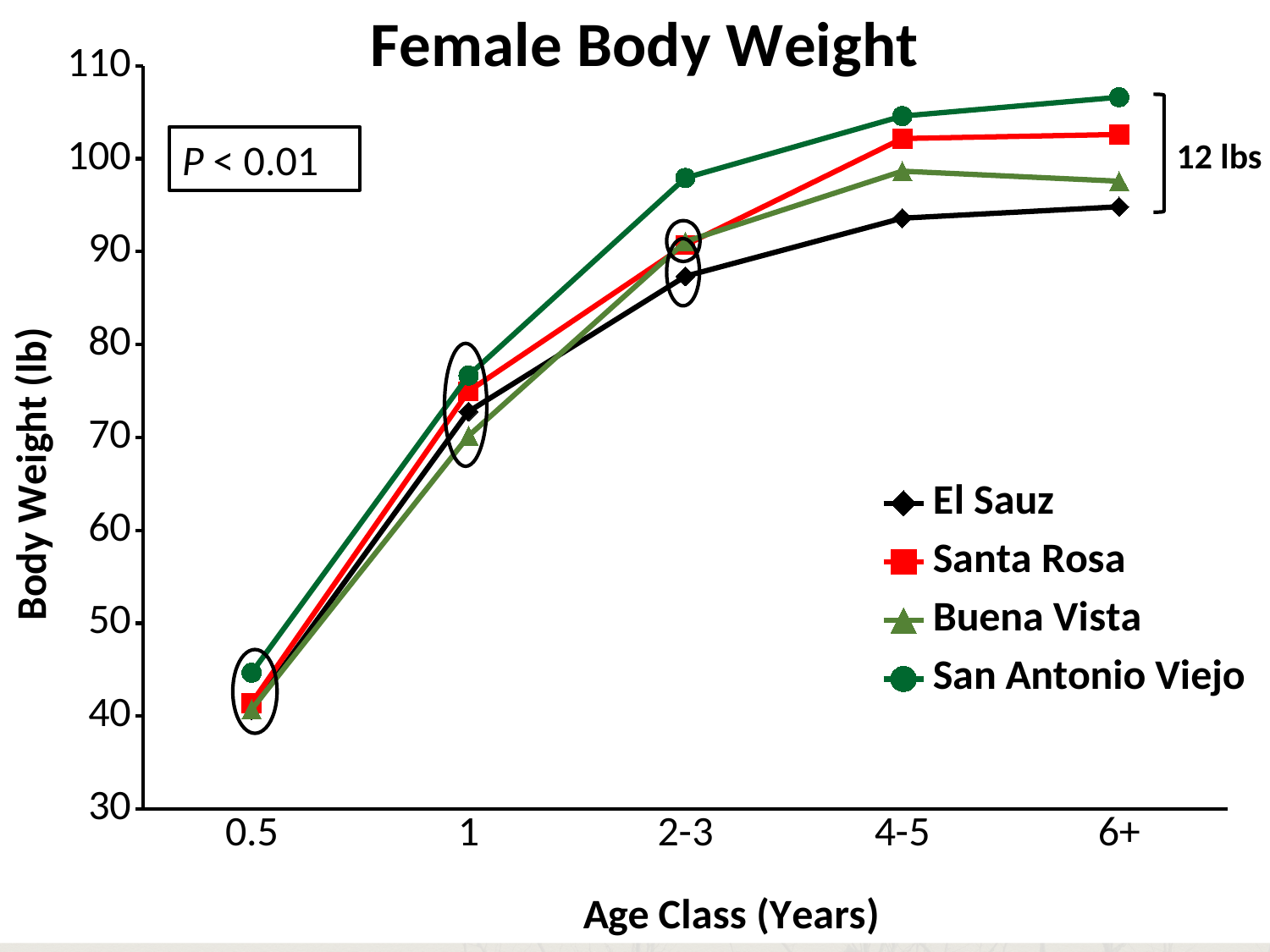
Which ranch has the highest female body weight at age class 6+? San Antonio Viejo What kind of chart is shown on the slide? line chart Which ranch has the lowest female body weight at age class 6+? El Sauz Is the value for Buena Vista at age class 1 greater or less than 80? less Is the value for San Antonio Viejo at age class 2-3 greater or less than 90? greater What is the title of the chart? Female Body Weight Does the El Sauz line rise or fall as age class increases along the x axis? rise How many series does the legend list? 4 At age class 4-5, which is larger: the value for Santa Rosa or the value for El Sauz? Santa Rosa Which ranch has the highest female body weight at age class 0.5? San Antonio Viejo Is the value for El Sauz at age class 0.5 greater or less than 50? less How many age classes are shown on the x axis? 5